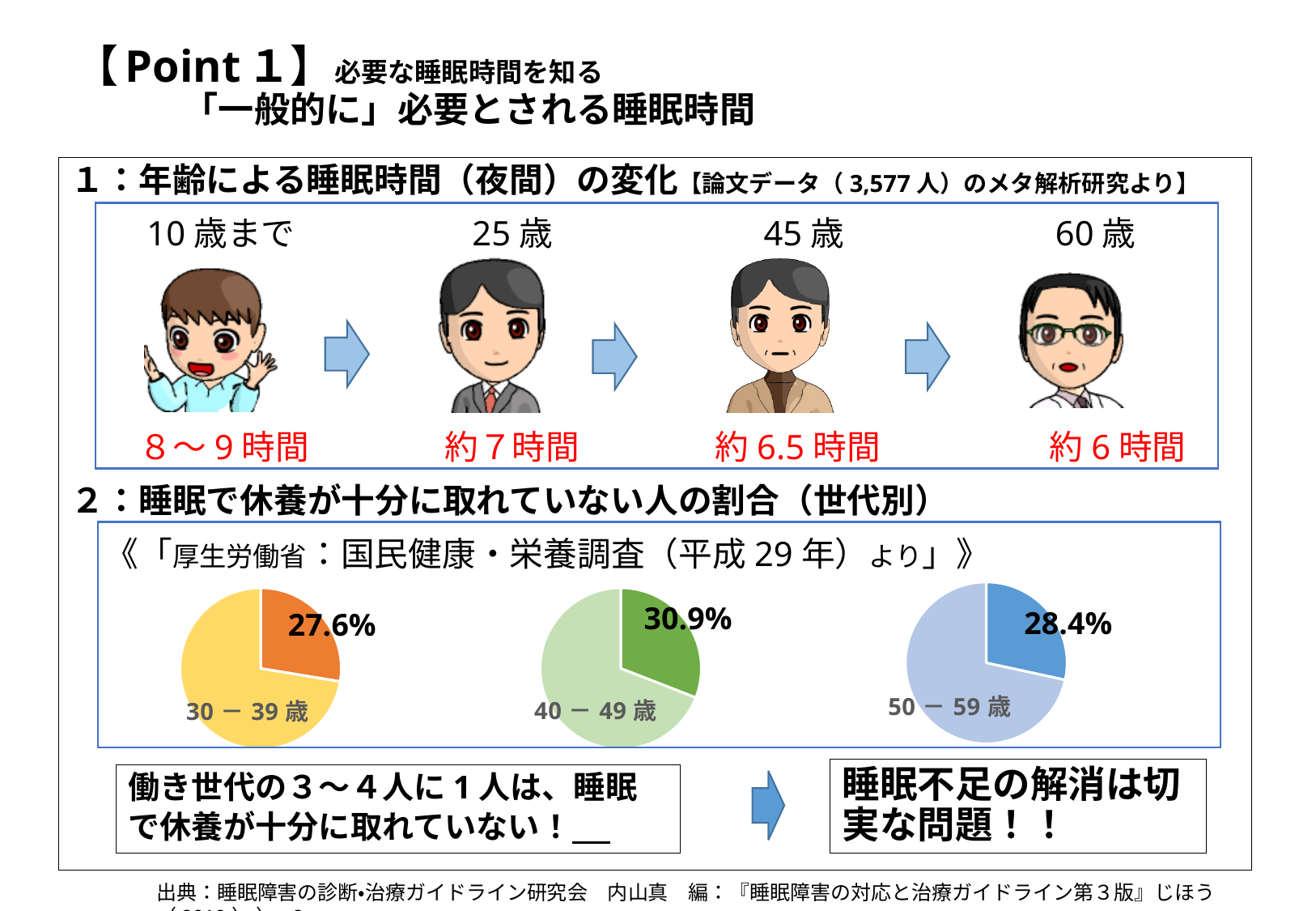
Which is larger: the labelled percentage in the 40－49歳 pie chart or the 50－59歳 pie chart? 40－49歳 How many pie charts are shown in section 2 of the slide? 3 In the 30－39歳 pie chart, what percentage is shown for the highlighted slice? 27.6% What kind of chart is used to show the share of people not getting enough rest from sleep by age group? Pie chart Across the three pie charts, which age group has the highest labelled percentage? 40－49歳 What colour is the highlighted slice in the 50－59歳 pie chart? Blue What is the difference between the labelled percentage in the 50－59歳 pie chart and the 30－39歳 pie chart? 0.8% What colour is the highlighted slice in the 30－39歳 pie chart? Orange In the 40－49歳 pie chart, what percentage is shown for the highlighted slice? 30.9% What is the difference between the labelled percentage in the 40－49歳 pie chart and the 30－39歳 pie chart? 3.3% In the 50－59歳 pie chart, what percentage is shown for the highlighted slice? 28.4% Across the three pie charts, which age group has the lowest labelled percentage? 30－39歳